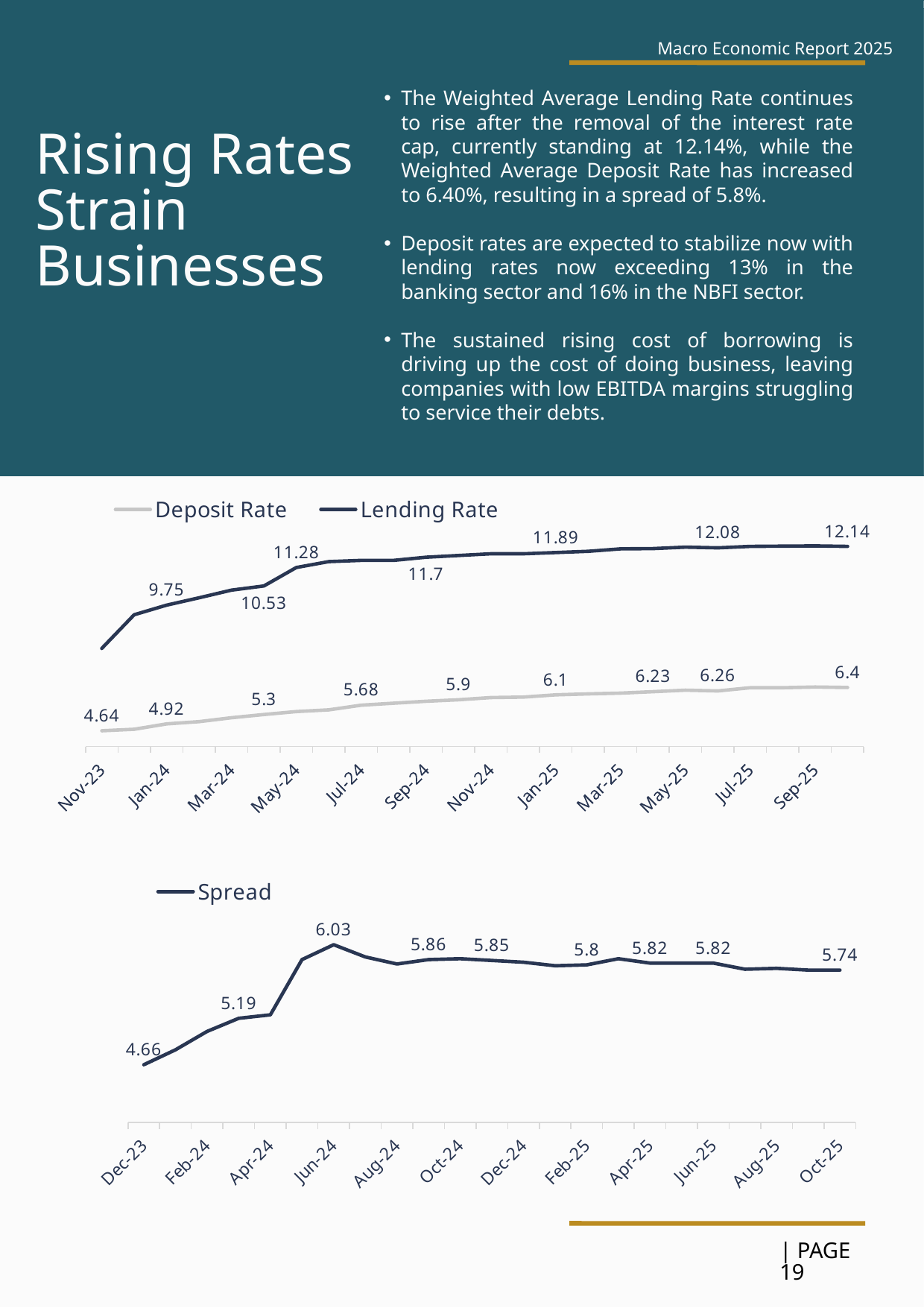
How many series does the legend of the top chart list? 2 In the bottom Spread chart, what is the difference between the highest labelled value (6.03) and the lowest labelled value (4.66)? 1.37 In the bottom Spread chart, what is the lowest labelled value? 4.66 In the top chart, does the Lending Rate rise or fall from Nov-23 to the end of the series? rise In the top chart, what is the first labelled value of the Deposit Rate line, at Nov-23? 4.64 In the top chart, what is the last labelled value of the Lending Rate line? 12.14 In the bottom Spread chart, what is the highest labelled value? 6.03 In the top chart, what is the last labelled value of the Deposit Rate line? 6.4 What are the two series named in the legend of the top chart? Deposit Rate and Lending Rate What kind of chart is the top chart showing Deposit Rate and Lending Rate? line chart In the top chart, what is the difference between the final Lending Rate label (12.14) and the final Deposit Rate label (6.4)? 5.74 In the top chart, which series has higher values throughout, Deposit Rate or Lending Rate? Lending Rate